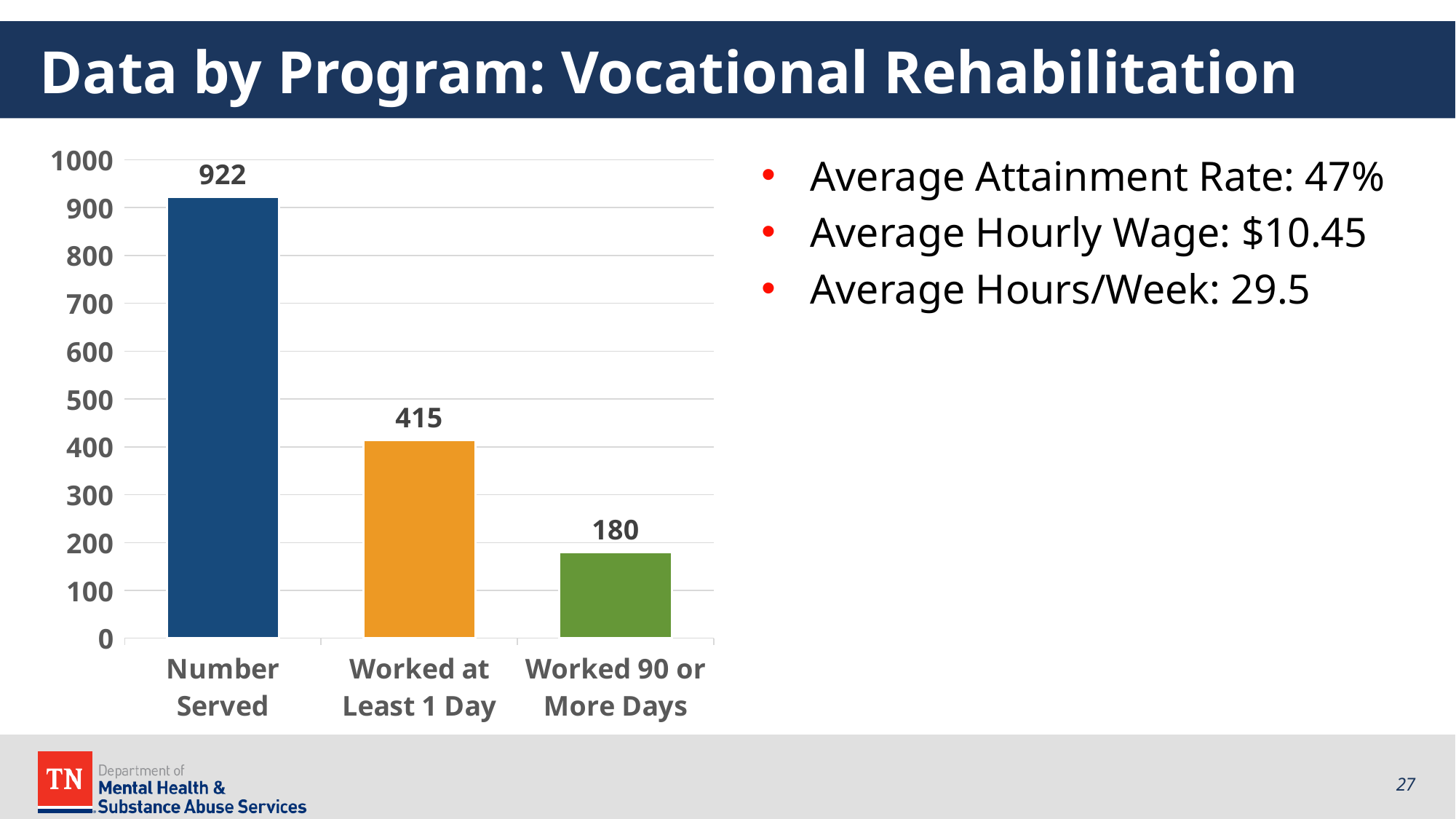
Is the value for Worked at Least 1 Day greater or less than 500? less What is the difference between Number Served and Worked at Least 1 Day? 507 Which category has the highest value? Number Served What is the value for Worked 90 or More Days? 180 What kind of chart is shown on the slide? bar chart What is the value for Worked at Least 1 Day? 415 Do the values rise or fall from left to right across the categories? fall What is the difference between Worked at Least 1 Day and Worked 90 or More Days? 235 What is the value for Number Served? 922 How many categories are shown in the chart? 3 Which is larger, Worked at Least 1 Day or Worked 90 or More Days? Worked at Least 1 Day Which category has the lowest value? Worked 90 or More Days